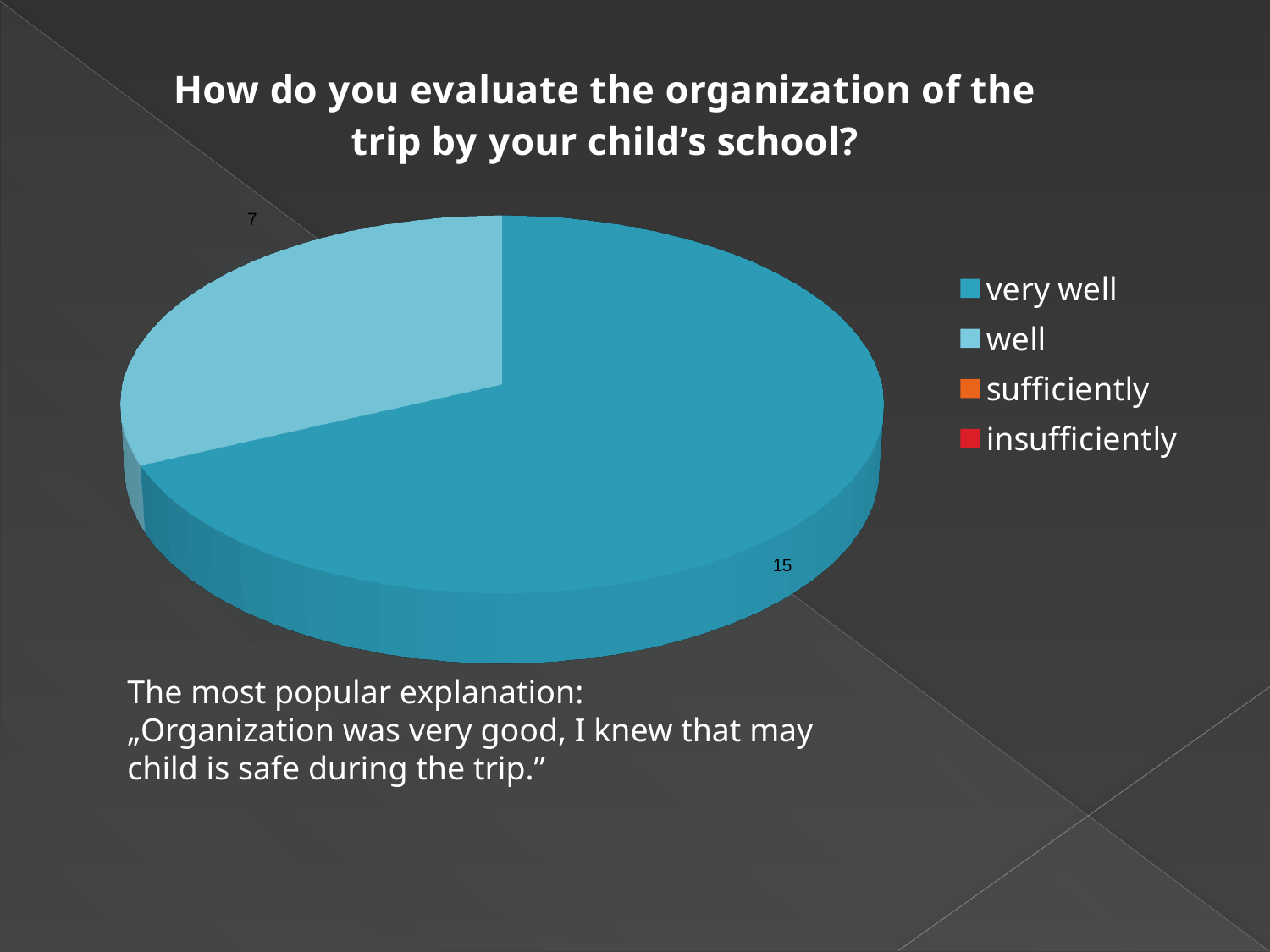
How many entries does the legend list? 4 What kind of chart is shown on the slide? pie chart What is the difference between the 'very well' value and the 'well' value? 8 Which legend entry is shown in red? insufficiently What is the value for the 'very well' slice? 15 Which is larger, the value for 'very well' or the value for 'well'? very well Of the slices with printed values, which category has the smallest value? well What is the value for the 'well' slice? 7 How many slices are visible in the pie chart? 2 What is the title of the chart? How do you evaluate the organization of the trip by your child's school? Which category has the largest slice of the pie? very well